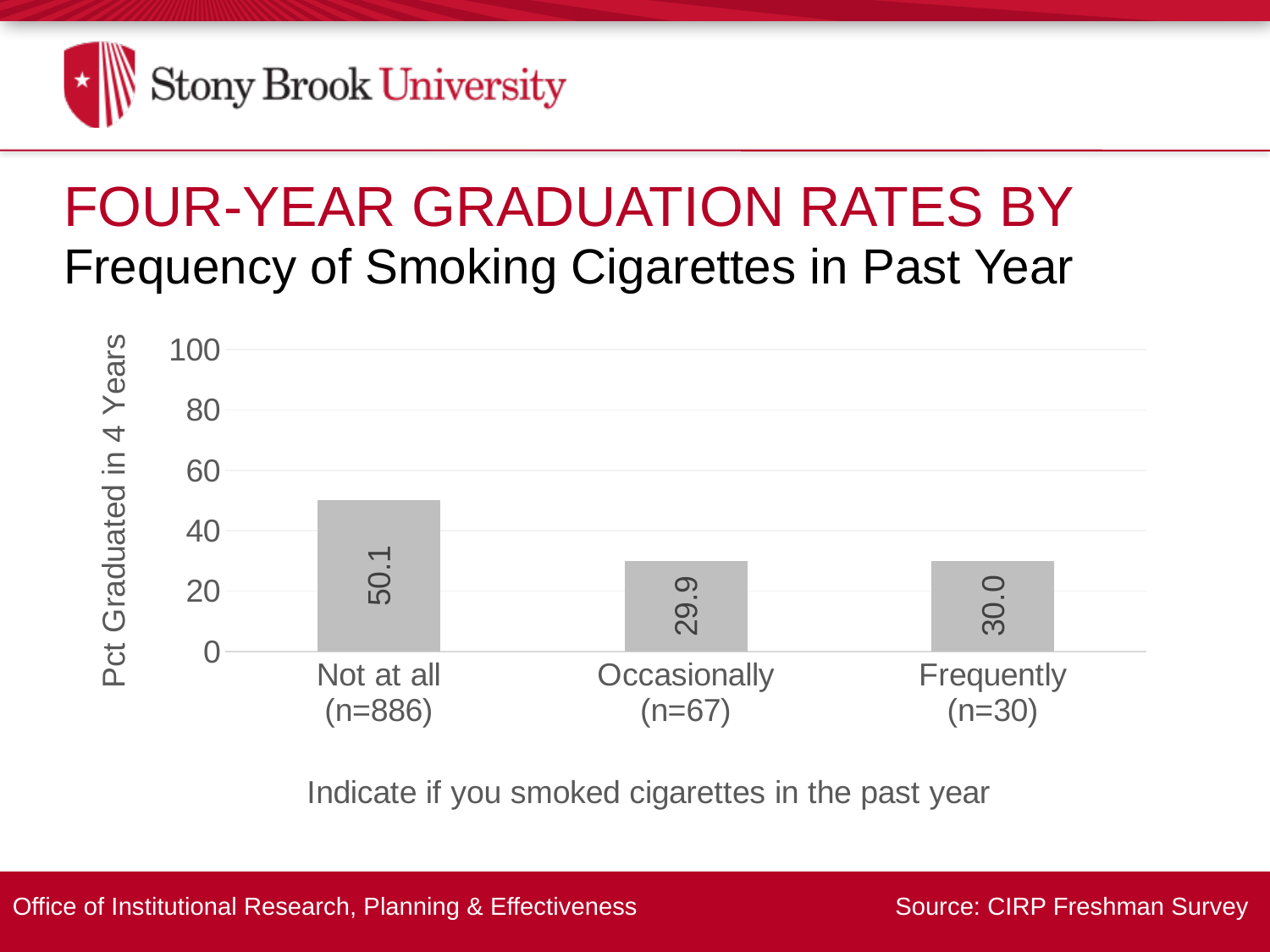
What is the four-year graduation rate for students who smoked cigarettes 'Occasionally'? 29.9 What is the difference in four-year graduation rate between the 'Not at all' and 'Frequently' categories? 20.1 Which smoking frequency category has the highest four-year graduation rate? Not at all What is the four-year graduation rate for students who smoked cigarettes 'Frequently'? 30.0 Which has a higher four-year graduation rate, 'Not at all' or 'Frequently'? Not at all What is the sample size (n) for the 'Not at all' category? 886 What is the four-year graduation rate for students who smoked cigarettes 'Not at all' in the past year? 50.1 What is the difference in four-year graduation rate between the 'Not at all' and 'Occasionally' categories? 20.2 Is the four-year graduation rate for 'Frequently' greater or less than 40? less What type of chart is used to show four-year graduation rates by smoking frequency? Bar chart Is the four-year graduation rate for 'Not at all' greater or less than 40? greater How many smoking frequency categories are shown in the chart? 3